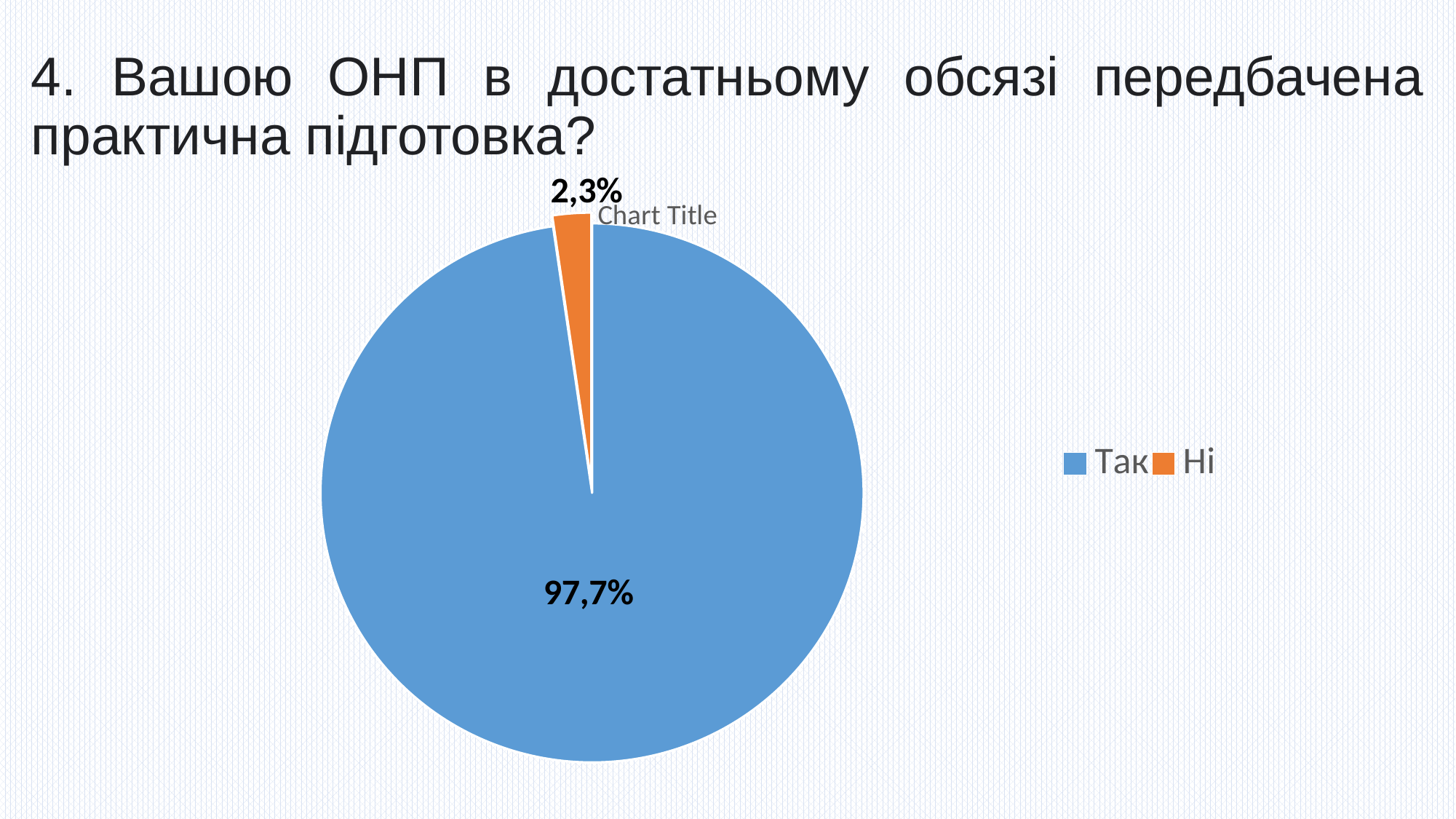
What is the value shown for the "Так" slice? 97,7% What colour is the "Ні" slice? orange What is the value shown for the "Ні" slice? 2,3% How many entries does the legend list? 2 Which is larger, the "Так" slice or the "Ні" slice? Так Which category has the largest slice of the pie? Так What kind of chart is shown on the slide? pie chart What is the difference between the "Так" and "Ні" values? 95,4% How many slices does the pie chart have? 2 What title is printed on the chart itself? Chart Title Which category has the smallest slice of the pie? Ні